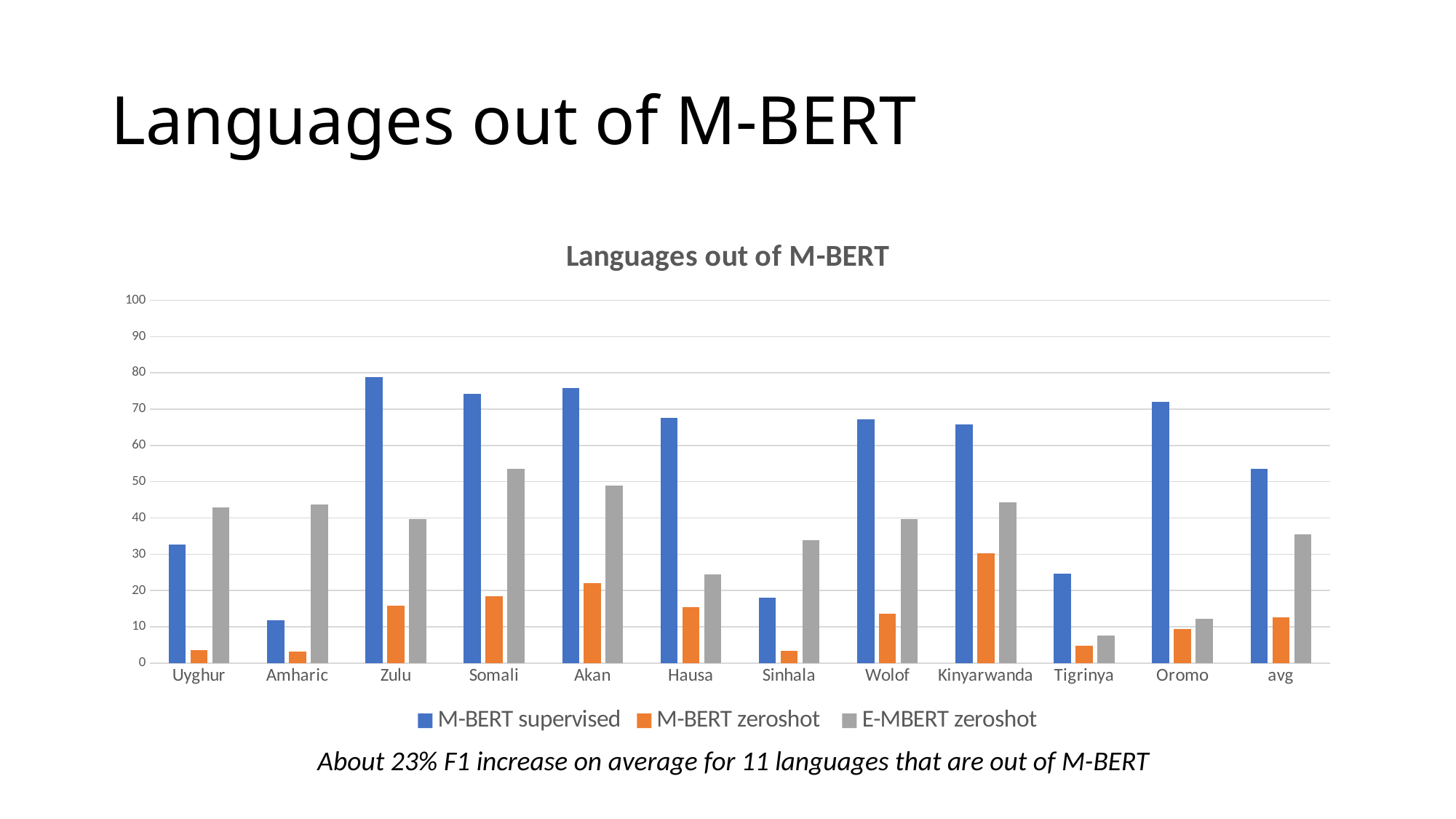
Which language has the highest M-BERT supervised value? Zulu What is the title of the chart? Languages out of M-BERT Which language has the highest M-BERT zeroshot value? Kinyarwanda Which language has the lowest E-MBERT zeroshot value? Tigrinya How many series does the legend list? 3 Is the E-MBERT zeroshot value for Amharic greater or less than 40? greater Which language has the lowest M-BERT supervised value? Amharic Is the M-BERT supervised value for Zulu greater or less than 70? greater How many categories are shown on the x axis? 12 What kind of chart is shown on the slide? bar chart Is the M-BERT supervised value for Sinhala greater or less than 20? less For Uyghur, which is larger: the M-BERT supervised value or the E-MBERT zeroshot value? E-MBERT zeroshot